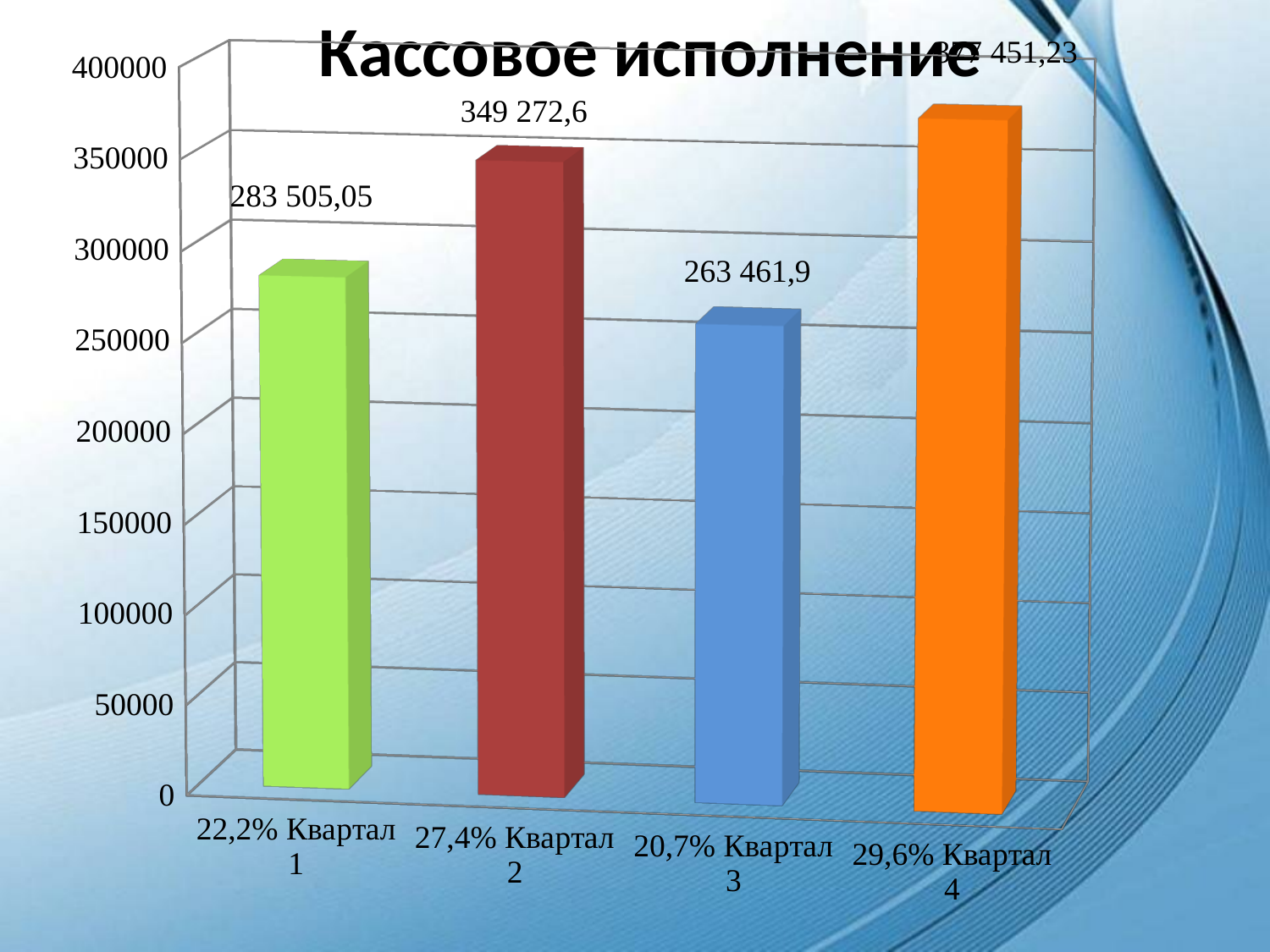
What is the value for Квартал 2? 349 272,6 What is the difference between the values for Квартал 1 and Квартал 3? 20 043,15 What is the title of the chart? Кассовое исполнение What is the value for Квартал 1? 283 505,05 Which quarter has the highest value? Квартал 4 Is the value for Квартал 4 greater or less than 350000? greater Which is larger, the value for Квартал 2 or the value for Квартал 3? Квартал 2 What is the difference between the values for Квартал 2 and Квартал 1? 65 767,55 Which quarter has the lowest value? Квартал 3 How many bars are shown in the chart? 4 What kind of chart is shown on the slide? bar chart What is the value for Квартал 3? 263 461,9